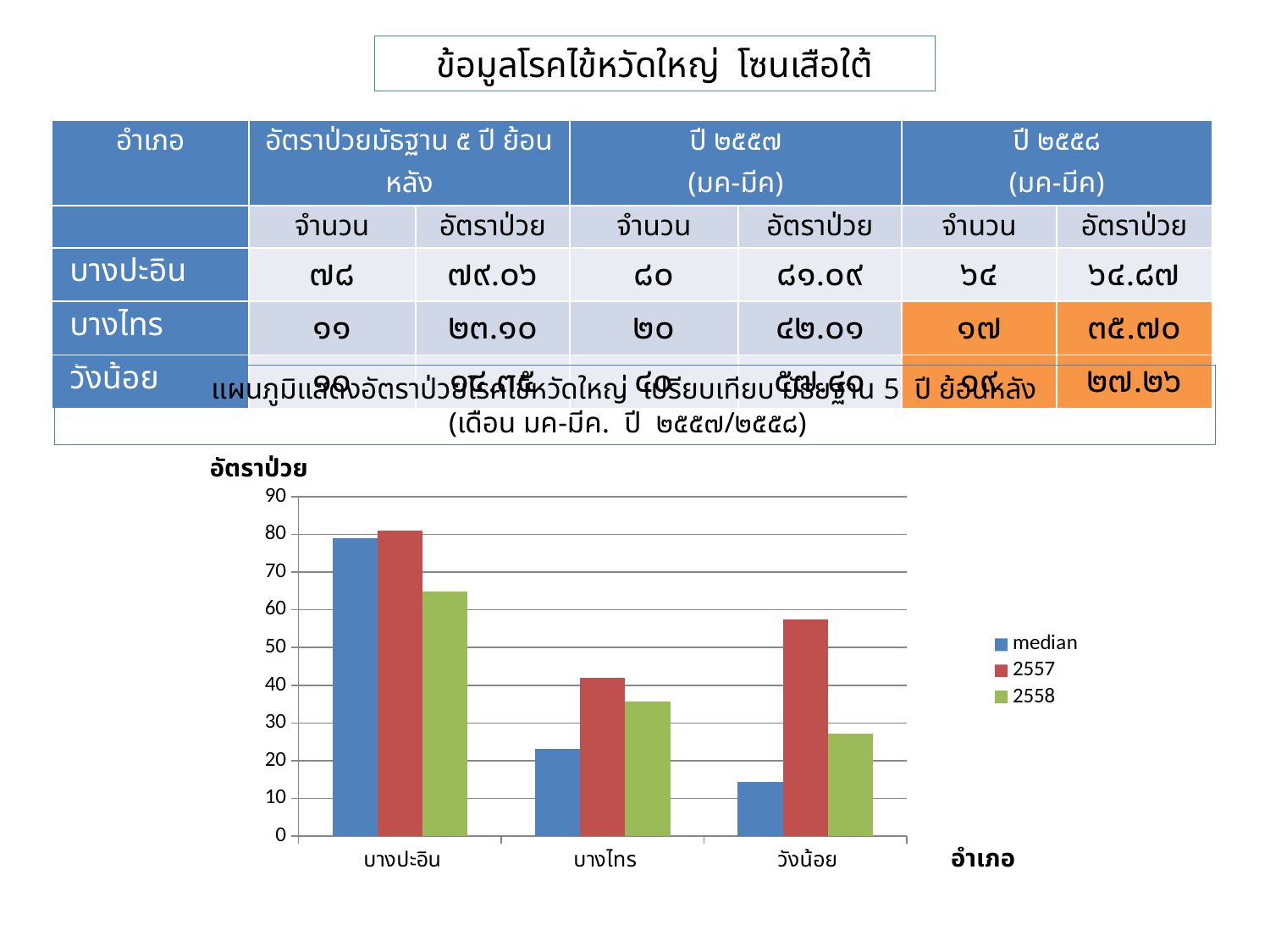
For บางไทร, which is larger: the 2557 value or the 2558 value? 2557 How many series does the chart legend list? 3 What is the label on the vertical axis of the chart? อัตราป่วย What kind of chart is shown on the slide? bar chart Which district has the highest value for the 2558 series? บางปะอิน Is the median value for บางปะอิน greater or less than 70? greater Is the 2557 value for วังน้อย greater or less than 50? greater Which district has the highest value for the 2557 series? บางปะอิน What are the entries in the chart legend? median, 2557, 2558 How many districts (categories) are shown on the x axis of the chart? 3 Is the 2558 value for บางไทร greater or less than 40? less Which district has the lowest value for the median series? วังน้อย